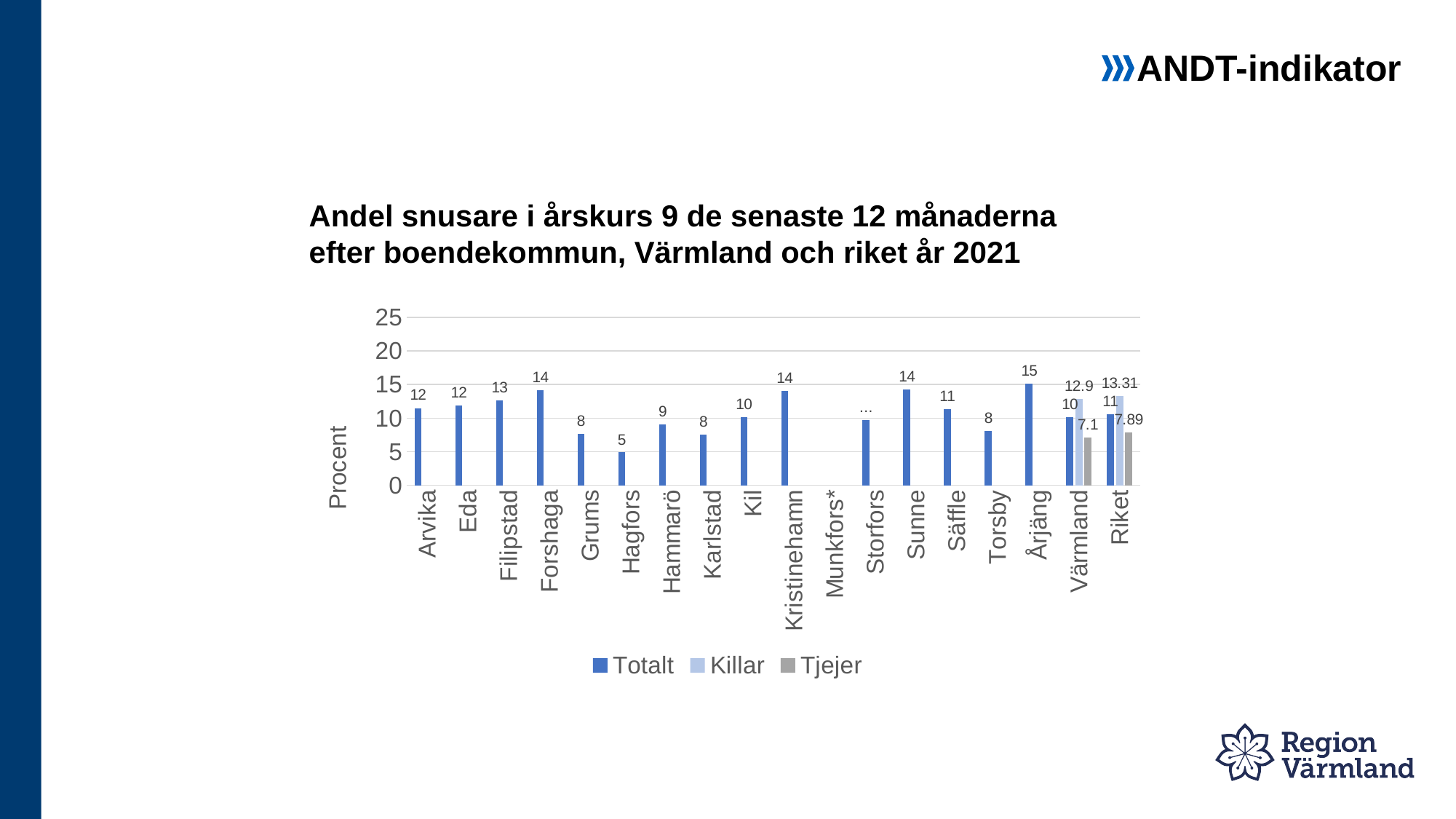
What is the Killar value for Riket? 13.31 How many series does the legend list? 3 What is the Tjejer value for Värmland? 7.1 What is the Totalt value for Årjäng? 15 Is the Totalt value for Kristinehamn greater or less than 10? greater What is the difference between the Totalt values for Forshaga and Grums? 6 What type of chart is shown on the slide? bar chart Which municipality has the highest Totalt value? Årjäng Which is larger, the Killar value for Värmland or the Killar value for Riket? Riket What is the label on the vertical axis? Procent Which municipality has the lowest labelled Totalt value? Hagfors What is the Totalt value for Hagfors? 5